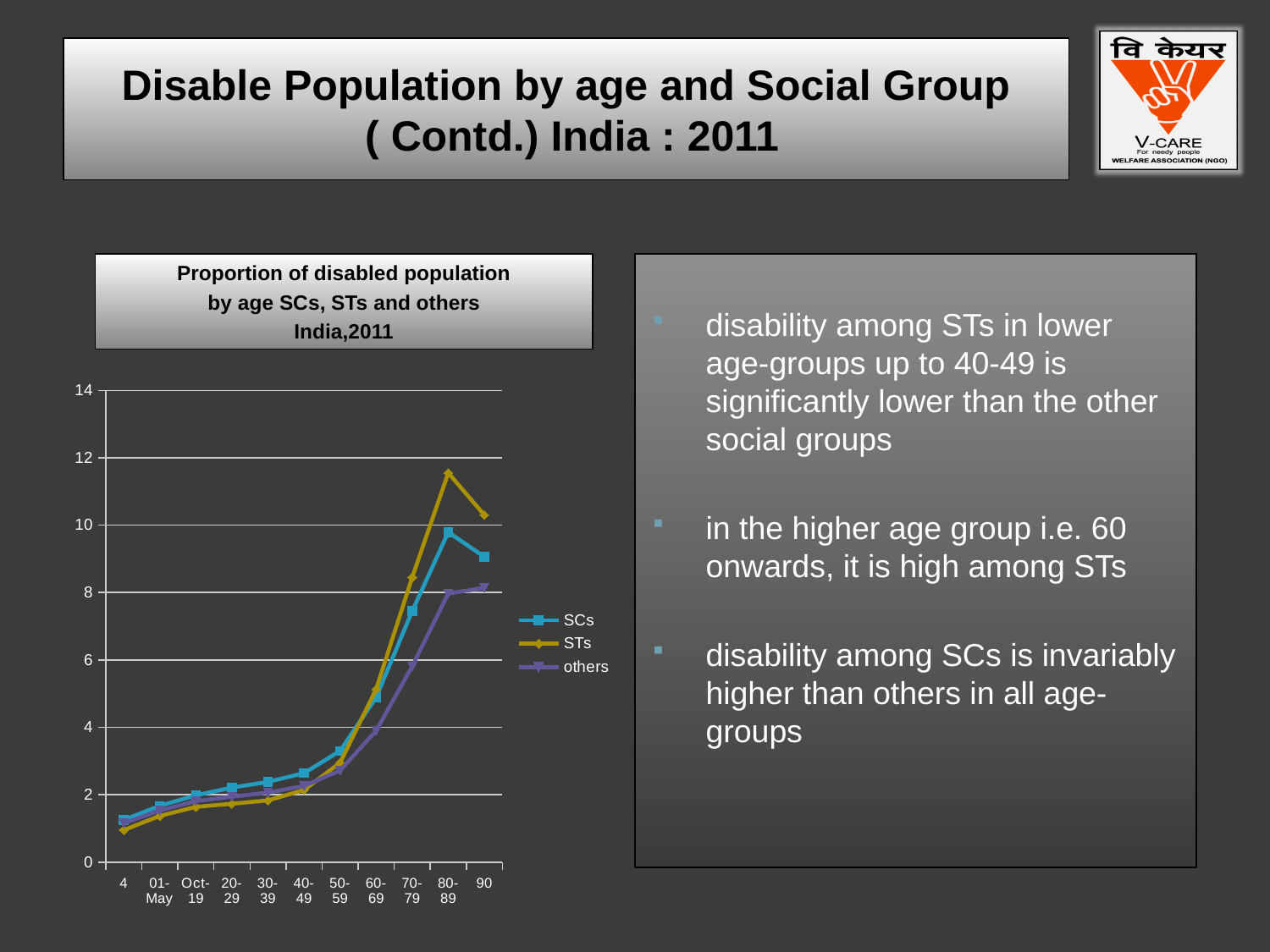
What is the title of the chart? Proportion of disabled population by age SCs, STs and others India,2011 Which age group has the highest value for STs? 80-89 In the 80-89 age group, which series has the larger value, STs or SCs? STs Is the value for STs in the 80-89 age group greater or less than 10? greater Which age group has the highest value for SCs? 80-89 How many age-group categories are shown on the x axis? 11 What kind of chart is shown on the slide? line chart Is the value for SCs in the 80-89 age group greater or less than 8? greater How many series does the legend list? 3 In the 20-29 age group, which series has the larger value, SCs or STs? SCs Is the value for others in the 4 age group greater or less than 2? less Which age group has the lowest value for STs? 4